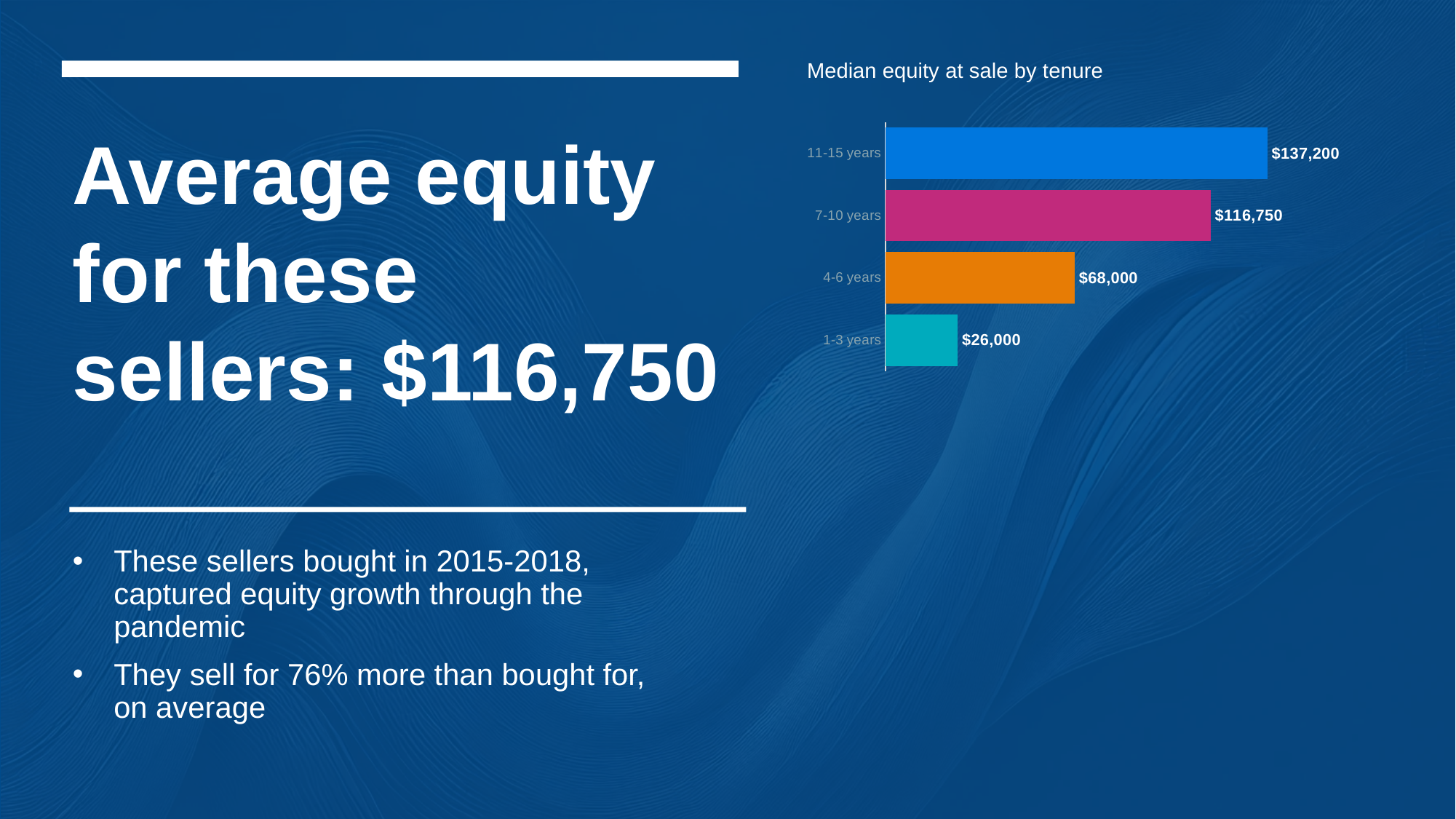
Which tenure group has the lowest median equity at sale? 1-3 years Which tenure group has the highest median equity at sale? 11-15 years What is the median equity at sale for sellers with 11-15 years of tenure? $137,200 How many tenure categories are shown in the chart? 4 What type of chart is used to show median equity at sale by tenure? Bar chart What is the title of the chart? Median equity at sale by tenure What is the median equity at sale for sellers with 1-3 years of tenure? $26,000 Which has a larger median equity at sale: the 4-6 years group or the 7-10 years group? 7-10 years What is the median equity at sale for sellers with 4-6 years of tenure? $68,000 What is the difference in median equity at sale between the 4-6 years and 1-3 years groups? $42,000 What is the difference in median equity at sale between the 11-15 years and 7-10 years groups? $20,450 What is the median equity at sale for sellers with 7-10 years of tenure? $116,750